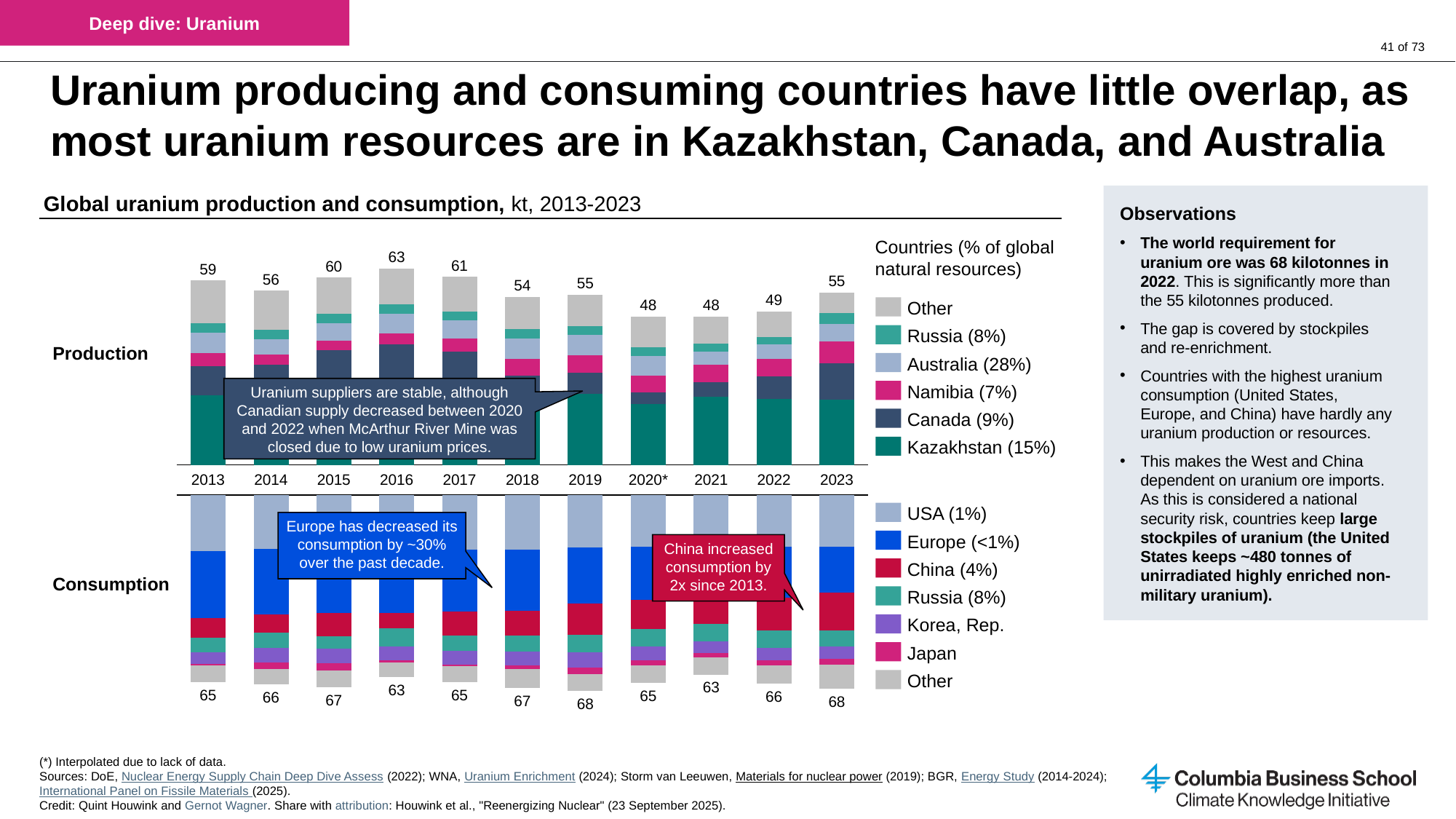
In the Production chart, which year had the highest total production? 2016 In the Consumption chart, what was the total uranium consumption in 2019? 68 What kind of chart is used to show production and consumption? Stacked bar chart In the Production chart, what is the lowest total production value shown? 48 How many series does the legend list for the Consumption chart? 7 In the Production chart, what was the total uranium production in 2016? 63 In the Production chart, which year had higher total production, 2013 or 2014? 2013 According to the Production legend, what share of global natural uranium resources does Australia hold? 28% How many years are shown on the x axis of the charts? 11 For 2023, how much larger is total consumption than total production? 13 In the Production chart, what is the difference between total production in 2016 and in 2021? 15 In the Production chart, did total production rise or fall from 2016 to 2021? Fall